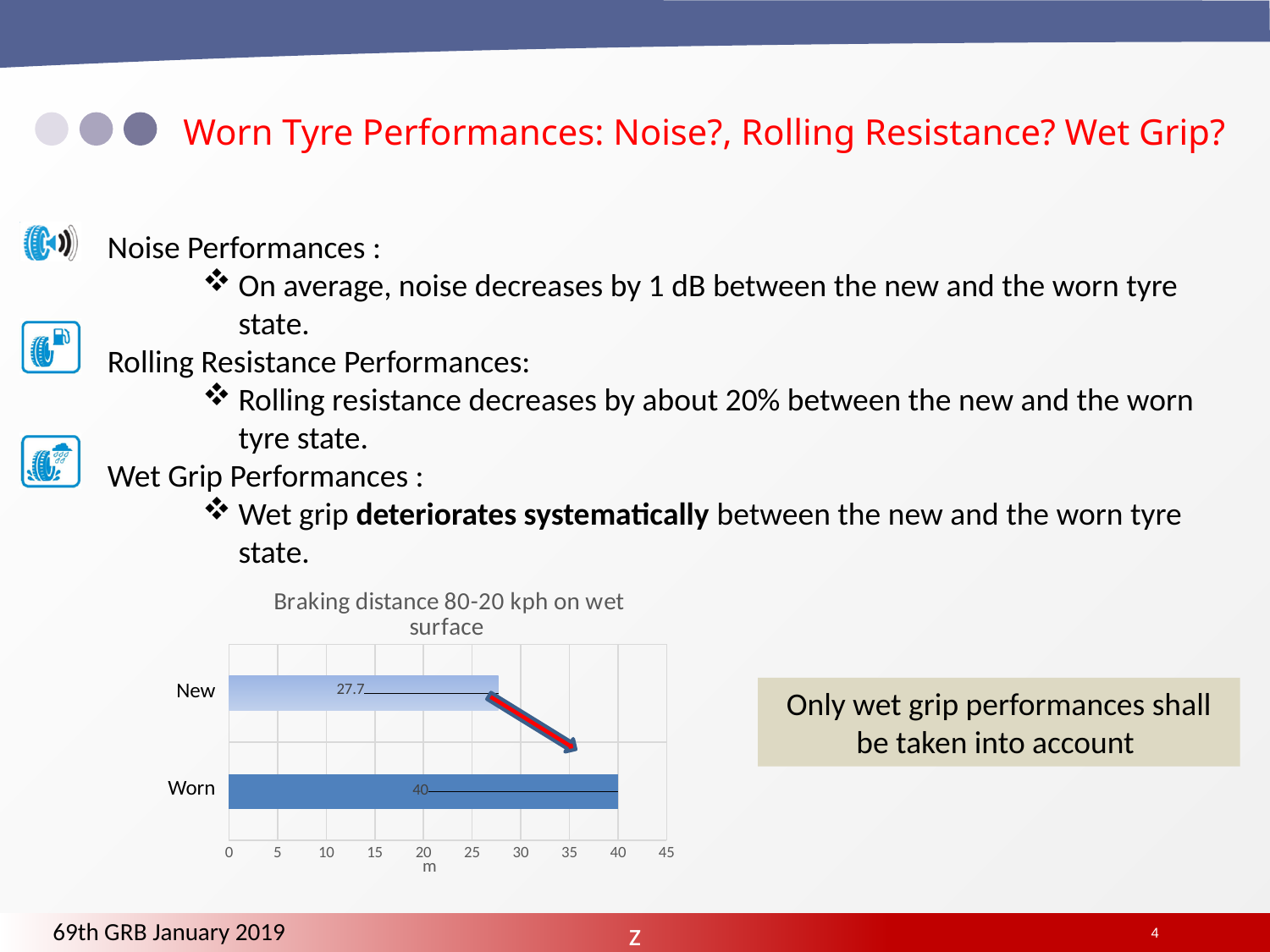
What is the title of the chart? Braking distance 80-20 kph on wet surface Is the braking distance for New larger or smaller than that for Worn? smaller How many categories are shown in the chart? 2 What kind of chart is shown on the slide? bar chart Which tyre state has the longer braking distance? Worn What is the braking distance for the Worn tyre state? 40 What is the maximum value shown on the x axis of the chart? 45 What is the difference in braking distance between the Worn and New tyre states? 12.3 Is the braking distance for New greater or less than 30? less What is the braking distance for the New tyre state? 27.7 Which tyre state has the shorter braking distance? New What unit is shown on the x axis of the chart? m